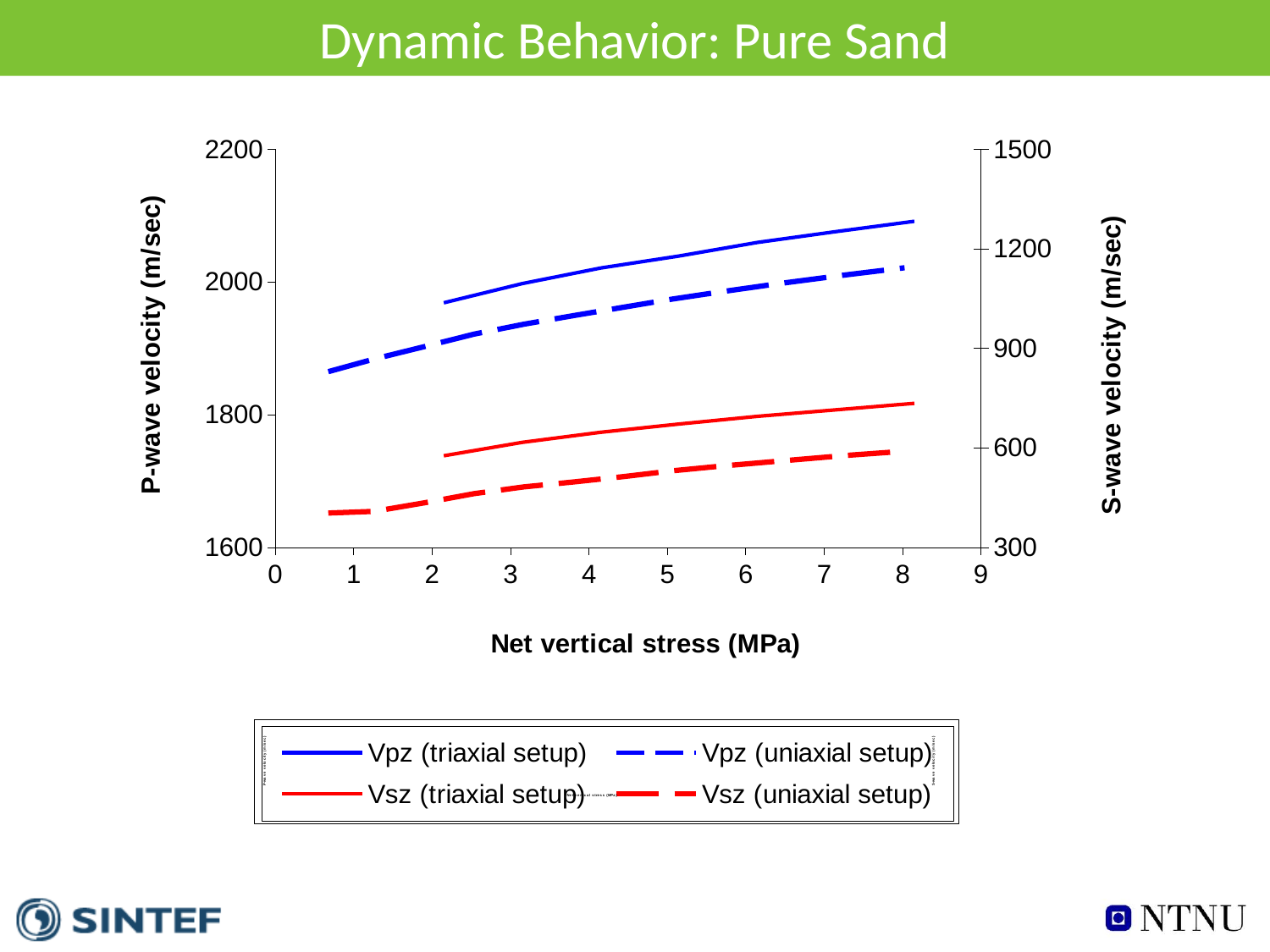
At 4 MPa, which is larger: Vpz (triaxial setup) or Vpz (uniaxial setup)? Vpz (triaxial setup) Which series has the highest values on the chart? Vpz (triaxial setup) Does Vsz (uniaxial setup) rise or fall as net vertical stress increases? Rise What is the title of the slide's chart? Dynamic Behavior: Pure Sand At 6 MPa, which is larger: Vsz (triaxial setup) or Vsz (uniaxial setup)? Vsz (triaxial setup) How many series does the legend list? 4 Does Vpz (triaxial setup) rise or fall as net vertical stress increases? Rise Which series has the lowest values on the chart? Vsz (uniaxial setup) What is the label of the x axis? Net vertical stress (MPa) Is the value for Vpz (uniaxial setup) at 1 MPa greater or less than 2000 on the P-wave velocity axis? less Is the value for Vpz (triaxial setup) at 8 MPa greater or less than 2000 on the P-wave velocity axis? greater What kind of chart is shown on the slide? Line chart